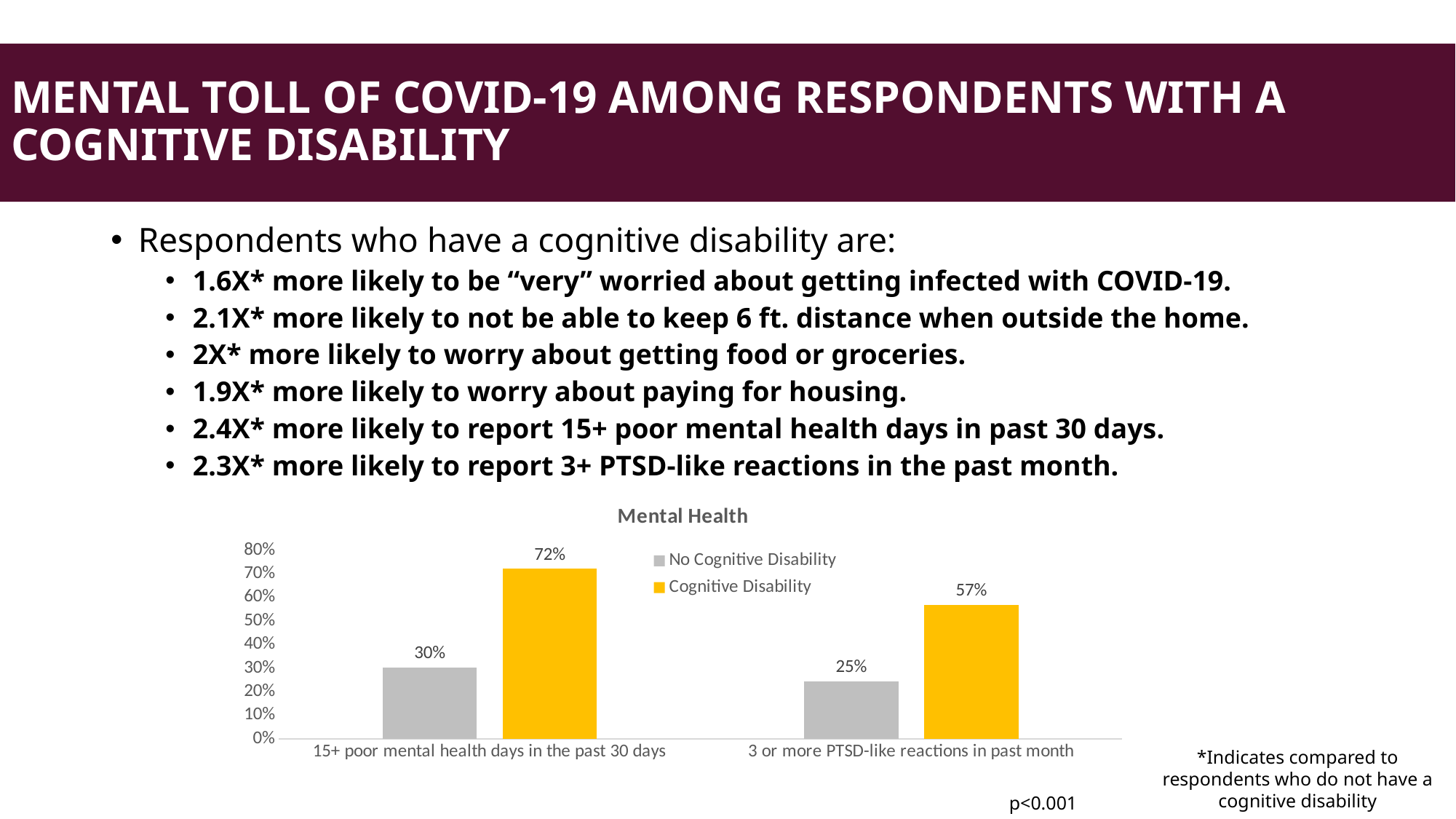
What is the value for No Cognitive Disability in the '15+ poor mental health days in the past 30 days' category? 30% How many series does the legend list? 2 What is the value for No Cognitive Disability in the '3 or more PTSD-like reactions in past month' category? 25% Which bar has the lowest value in the chart? No Cognitive Disability, 3 or more PTSD-like reactions in past month What is the difference between the Cognitive Disability and No Cognitive Disability values for '3 or more PTSD-like reactions in past month'? 32% What is the value for Cognitive Disability in the '15+ poor mental health days in the past 30 days' category? 72% Which is larger: the Cognitive Disability value for '3 or more PTSD-like reactions in past month' or the No Cognitive Disability value for '15+ poor mental health days in the past 30 days'? Cognitive Disability value for 3 or more PTSD-like reactions in past month Which bar has the highest value in the chart? Cognitive Disability, 15+ poor mental health days in the past 30 days What is the difference between the Cognitive Disability and No Cognitive Disability values for '15+ poor mental health days in the past 30 days'? 42% What kind of chart is shown on the slide? Bar chart What is the title of the chart? Mental Health What is the value for Cognitive Disability in the '3 or more PTSD-like reactions in past month' category? 57%